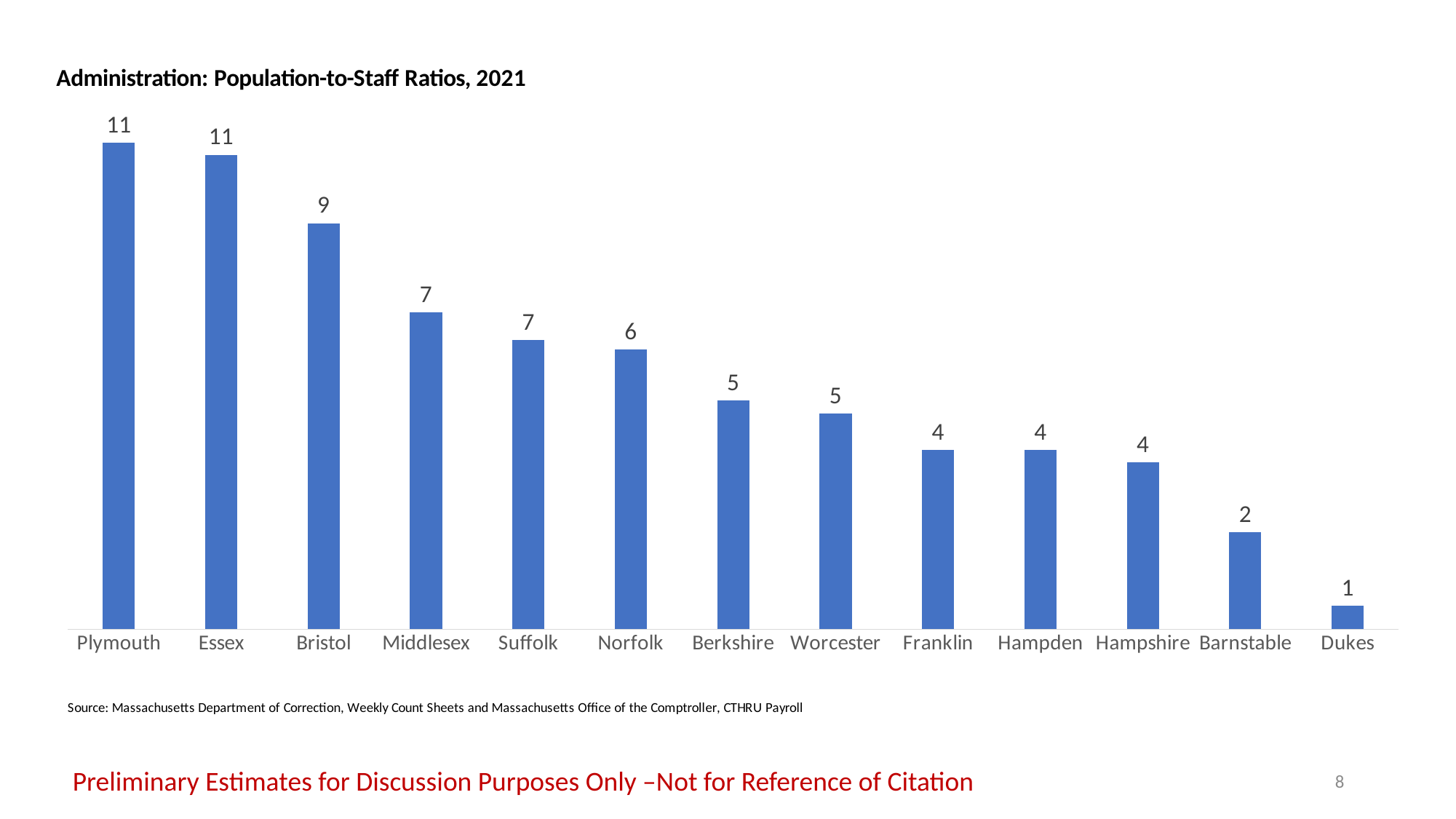
What is the population-to-staff ratio for Norfolk? 6 Which has a higher population-to-staff ratio, Bristol or Norfolk? Bristol What is the population-to-staff ratio for Barnstable? 2 What is the difference between the ratios for Plymouth and Berkshire? 6 What is the population-to-staff ratio for Bristol? 9 Which county has the lowest population-to-staff ratio? Dukes Do the values rise or fall moving from left to right along the x axis? Fall What is the population-to-staff ratio for Middlesex? 7 Which has a higher population-to-staff ratio, Barnstable or Worcester? Worcester What kind of chart is shown on the slide? Bar chart What is the difference between the ratios for Bristol and Dukes? 8 How many counties are shown in the chart? 13